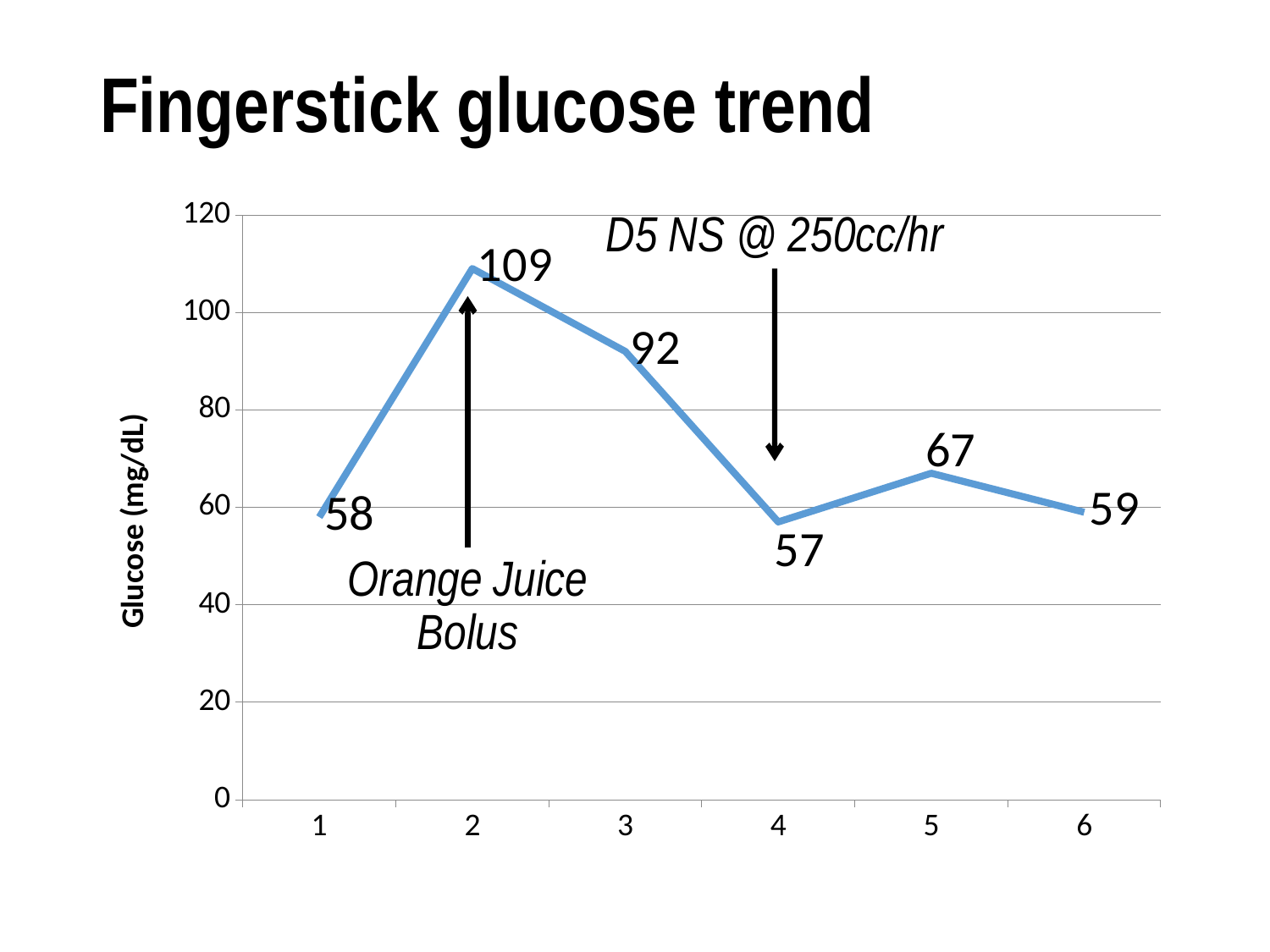
How many data points are plotted on the chart? 6 What is the glucose value at point 6? 59 What is the difference between the glucose values at point 2 and point 3? 17 Which is larger, the glucose value at point 1 or at point 5? point 5 What is the label on the y-axis of the chart? Glucose (mg/dL) At which x-axis point is the glucose value highest? 2 What is the glucose value at point 2? 109 What kind of chart is shown on the slide? line chart Is the glucose value at point 3 greater or less than 80? greater At which x-axis point is the glucose value lowest? 4 What is the difference between the glucose values at point 5 and point 4? 10 What is the glucose value at point 4? 57